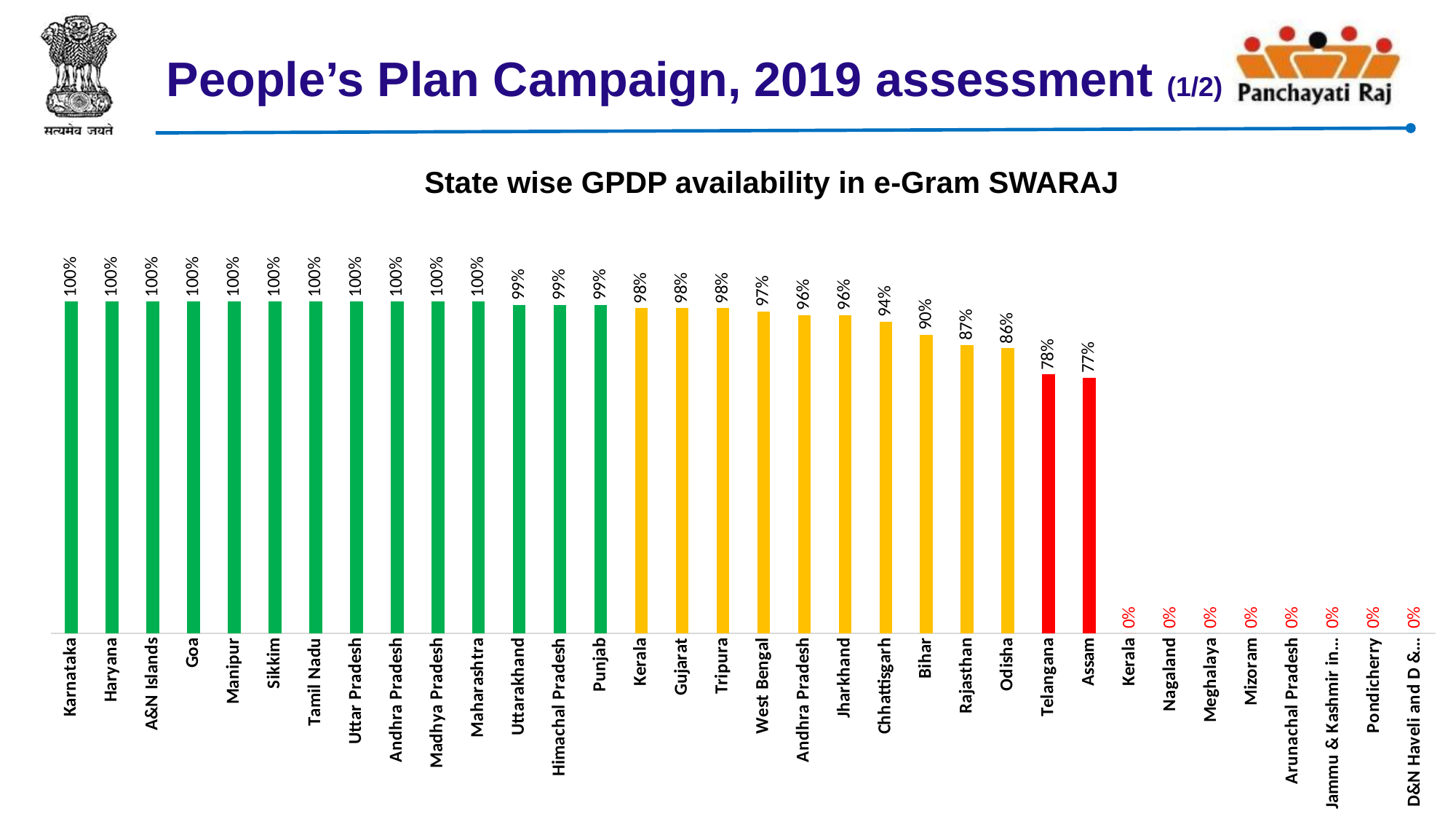
What is the title of the chart? State wise GPDP availability in e-Gram SWARAJ What is the difference between the values for Bihar and Odisha? 4% Which has a higher value, Rajasthan or Odisha? Rajasthan What is the highest value shown on the chart? 100% Do the values rise or fall from left to right along the x axis? Fall What is the value shown for Assam? 77% What is the value shown for West Bengal? 97% What kind of chart is shown on the slide? Bar chart How many states/UTs are shown on the chart? 34 What is the value shown for Chhattisgarh? 94% What is the value shown for Telangana? 78% What is the GPDP availability value for Bihar? 90%